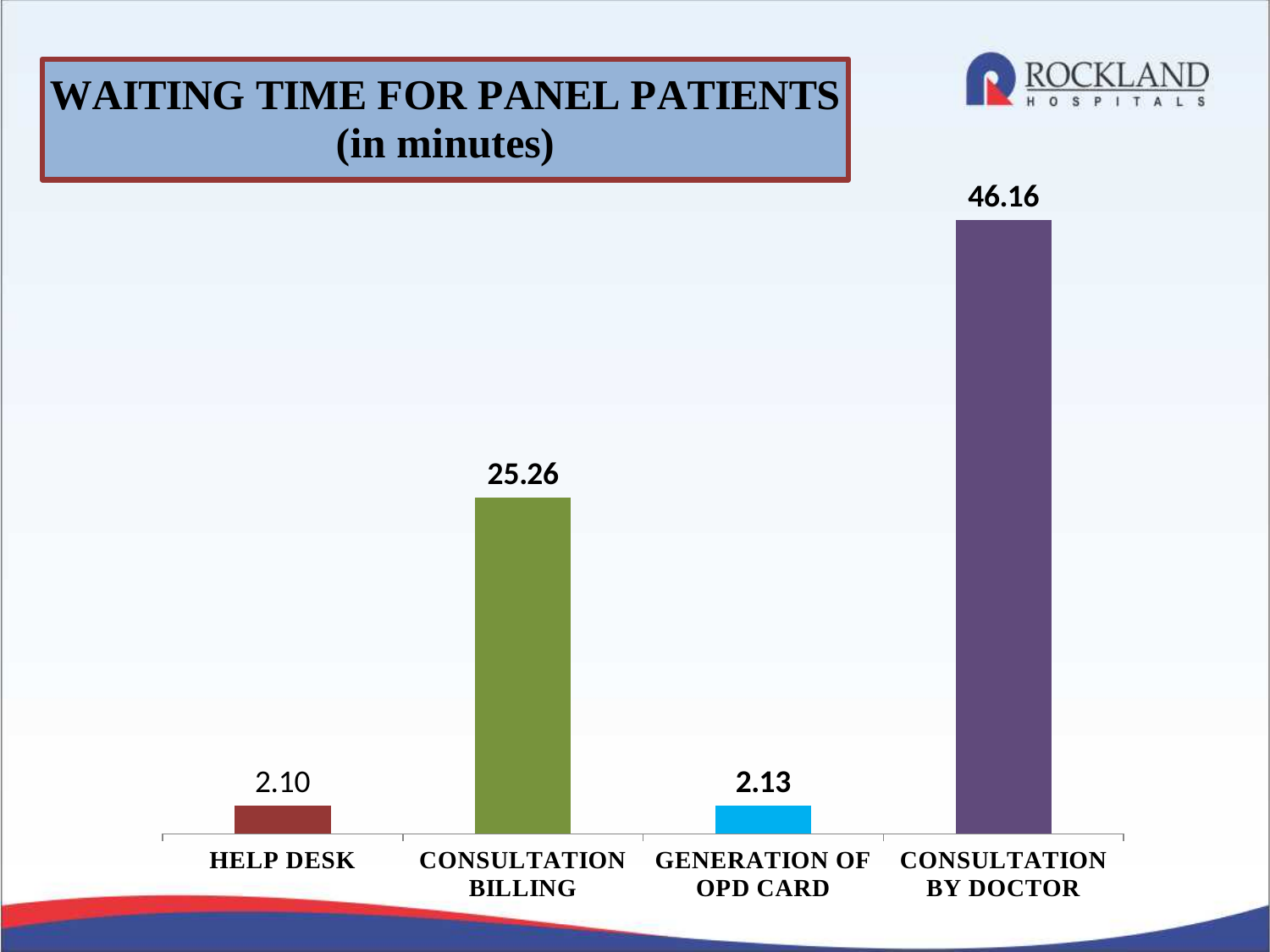
Which category has the lowest waiting time? Help Desk How many categories are shown in the chart? 4 Which has a larger waiting time, Consultation Billing or Generation of OPD Card? Consultation Billing What is the waiting time for Consultation Billing? 25.26 What is the difference in waiting time between Generation of OPD Card and Help Desk? 0.03 What is the waiting time for Consultation by Doctor? 46.16 What is the waiting time for Generation of OPD Card? 2.13 What kind of chart is shown on the slide? Bar chart What is the waiting time for Help Desk? 2.10 What is the title of the chart? WAITING TIME FOR PANEL PATIENTS (in minutes) What is the difference in waiting time between Consultation by Doctor and Consultation Billing? 20.90 Which category has the highest waiting time? Consultation by Doctor